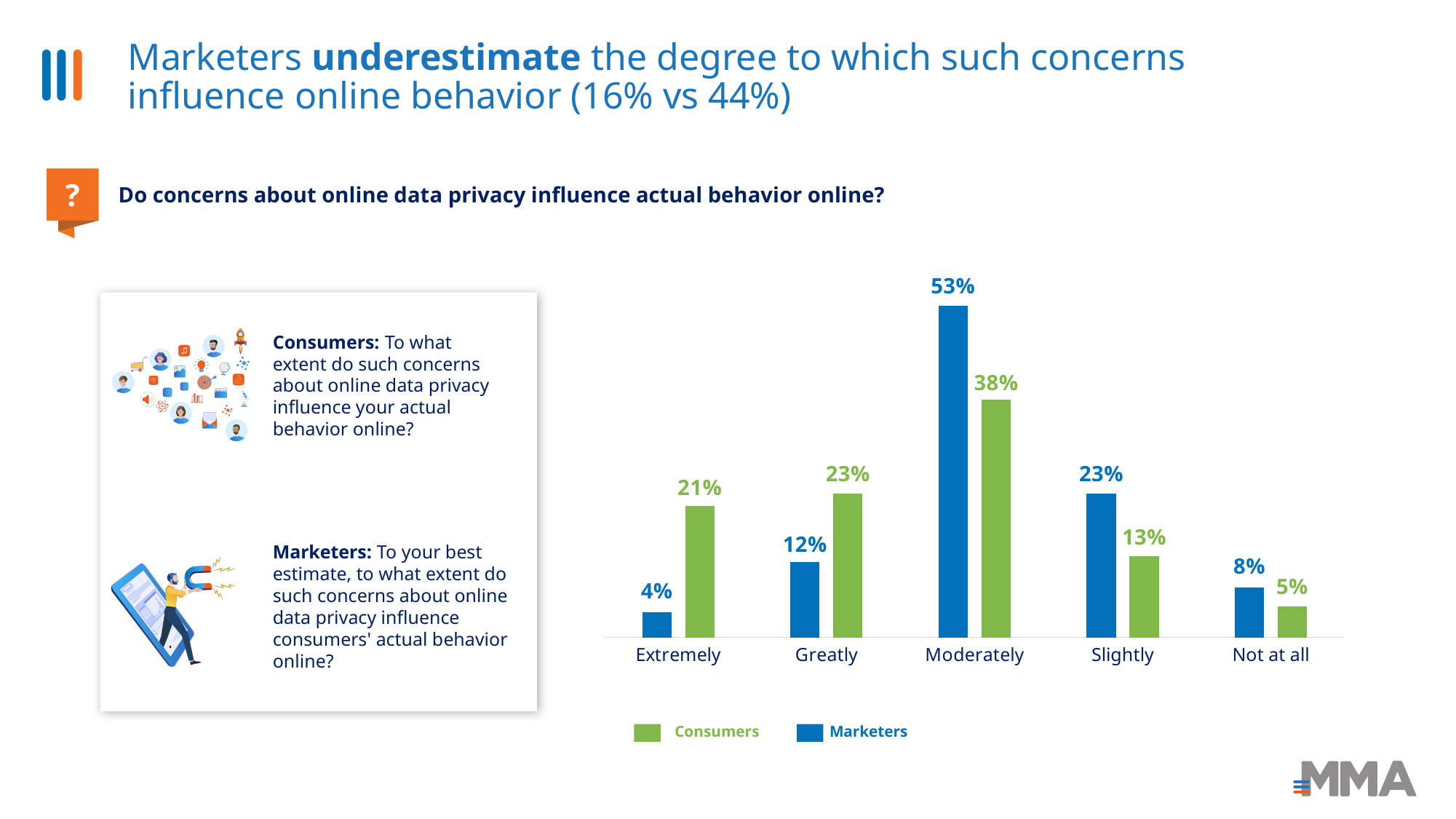
How many categories are shown on the x axis? 5 What is the Marketers value for Extremely? 4% How many series does the legend list? 2 What is the difference between the Consumers and Marketers values for Extremely? 17% Which category has the highest Marketers value? Moderately What is the Consumers value for Slightly? 13% What is the Consumers value for Moderately? 38% What is the difference between the Marketers and Consumers values for Moderately? 15% What kind of chart is shown on the slide? Bar chart For Greatly, which is larger: the Consumers value or the Marketers value? Consumers What is the Marketers value for Not at all? 8% Which category has the lowest Consumers value? Not at all